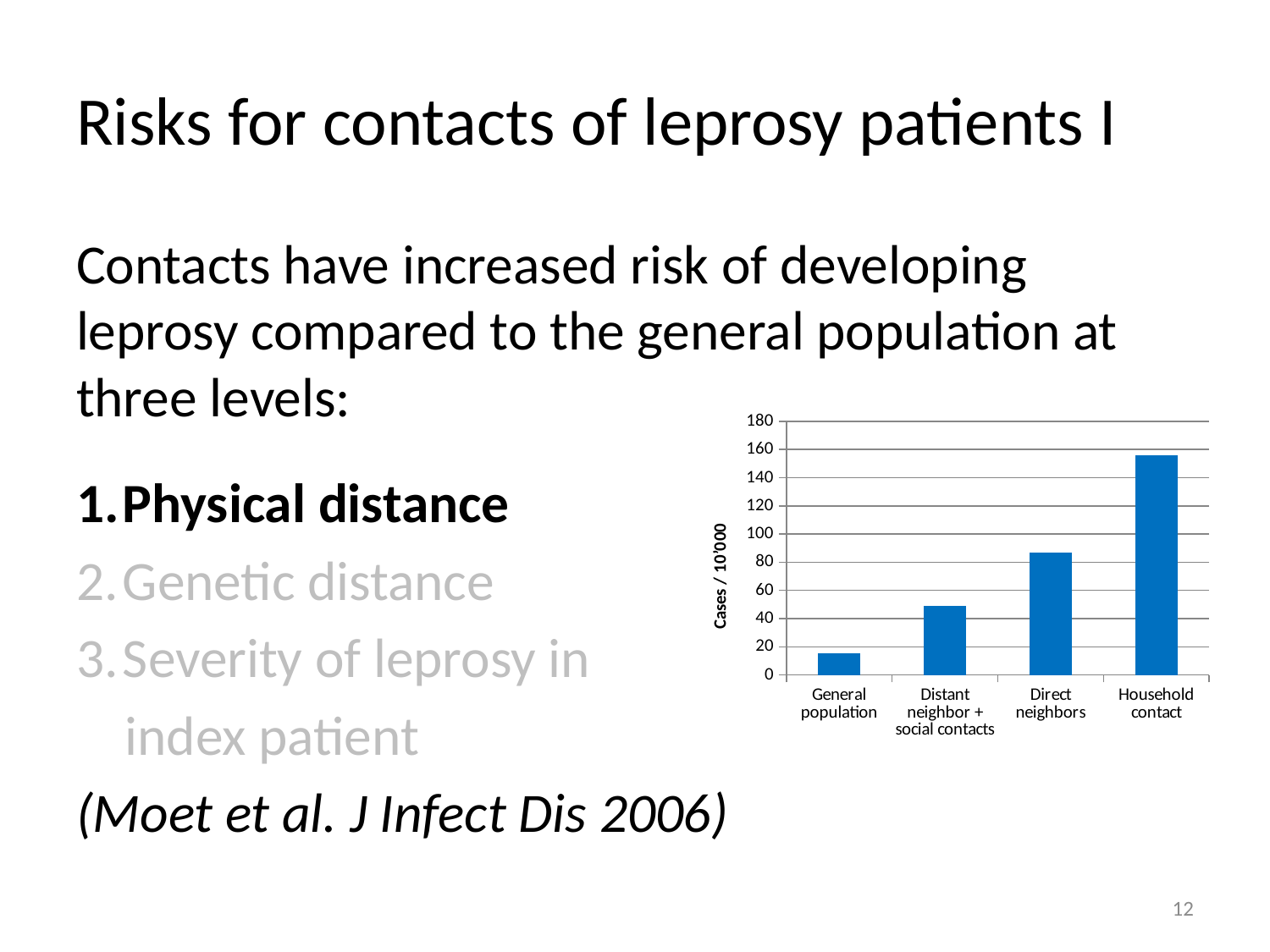
Which category has the highest value in the chart? Household contact What is the label on the vertical axis of the chart? Cases / 10'000 Do the values rise or fall from left to right along the x axis? rise Is the value for Direct neighbors greater or less than 80? greater How many categories are shown on the x axis of the chart? 4 Which is larger, the value for Direct neighbors or the value for Distant neighbor + social contacts? Direct neighbors Is the value for General population greater or less than 20? less What kind of chart is shown on the slide? bar chart What is the highest tick value shown on the vertical axis? 180 Is the value for Distant neighbor + social contacts greater or less than 60? less Which category has the lowest value in the chart? General population